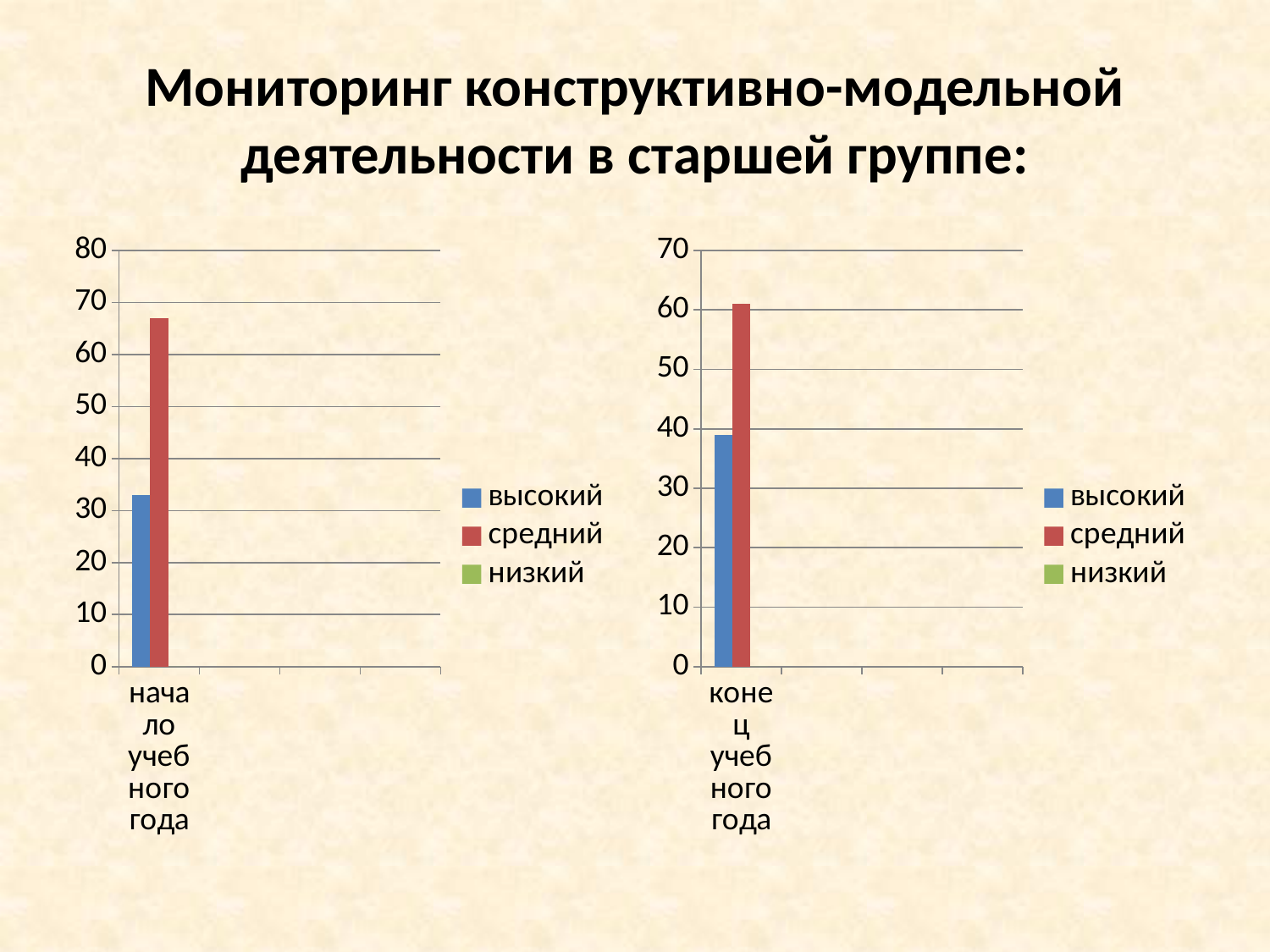
In the left chart (начало учебного года), which series has the highest bar? средний In the left chart (начало учебного года), is the value for средний greater or less than 60? greater How many series does the legend of the right chart list? 3 In the right chart (конец учебного года), which series has the highest bar? средний In the left chart (начало учебного года), is the value for высокий greater or less than 30? greater What colour represents the series средний in the legend of the left chart? red In the right chart (конец учебного года), is the value for высокий greater or less than 30? greater How many categories are shown on the x axis of the left chart? 1 In the right chart (конец учебного года), which is larger, the value for высокий or the value for средний? средний What kind of chart is the left chart on the slide? bar chart